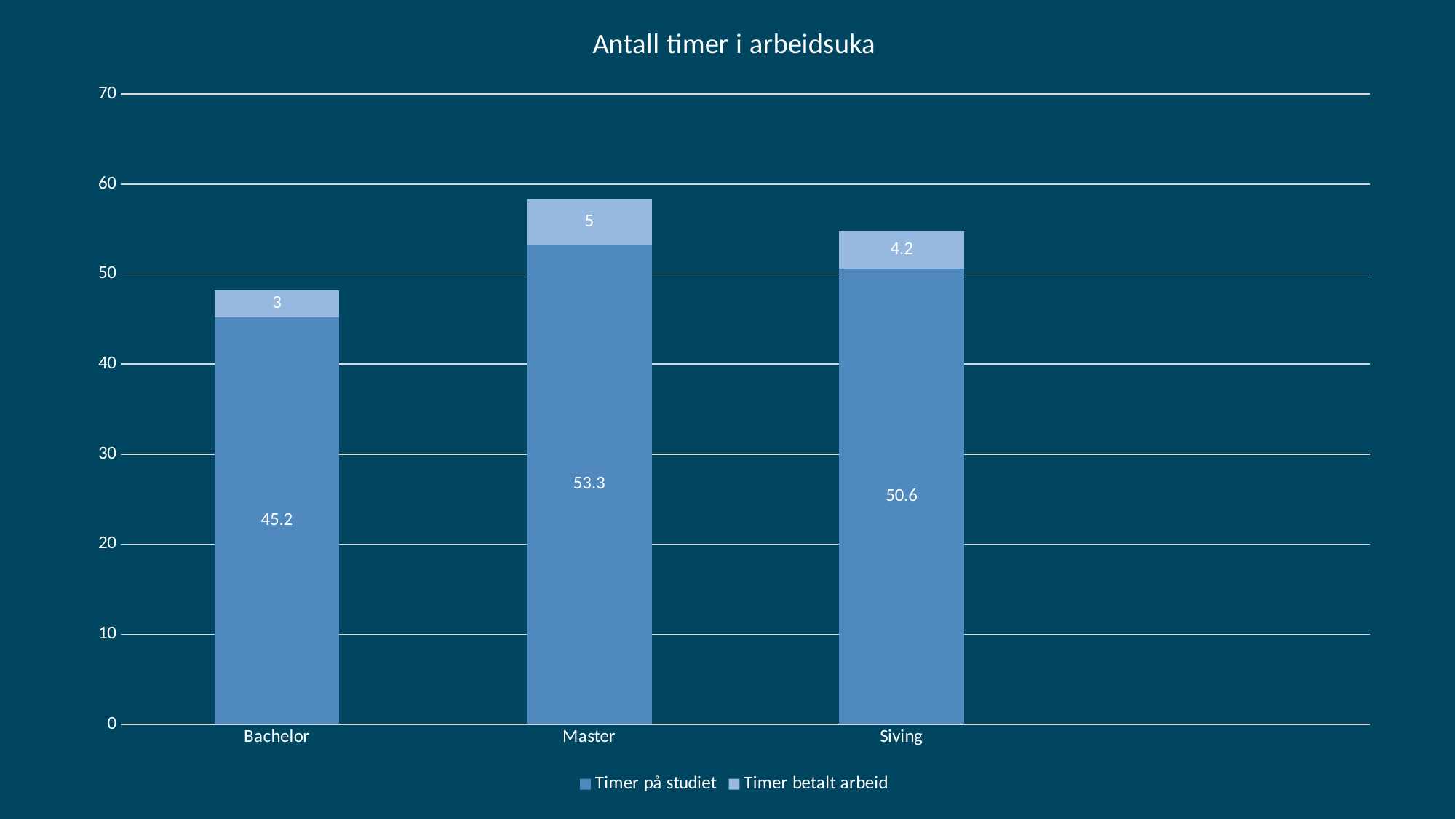
What is the total of the stacked bar for Bachelor? 48.2 What is the value of "Timer på studiet" for Master? 53.3 Which is larger: "Timer betalt arbeid" for Master or for Siving? Master What is the total of the stacked bar for Siving? 54.8 What is the difference between the "Timer på studiet" values for Master and Bachelor? 8.1 How many categories are shown on the x axis? 3 How many series does the legend list? 2 What is the value of "Timer på studiet" for Bachelor? 45.2 What is the value of "Timer betalt arbeid" for Siving? 4.2 Which category has the lowest value for "Timer betalt arbeid"? Bachelor Which category has the highest value for "Timer på studiet"? Master What kind of chart is shown on the slide? Stacked bar chart